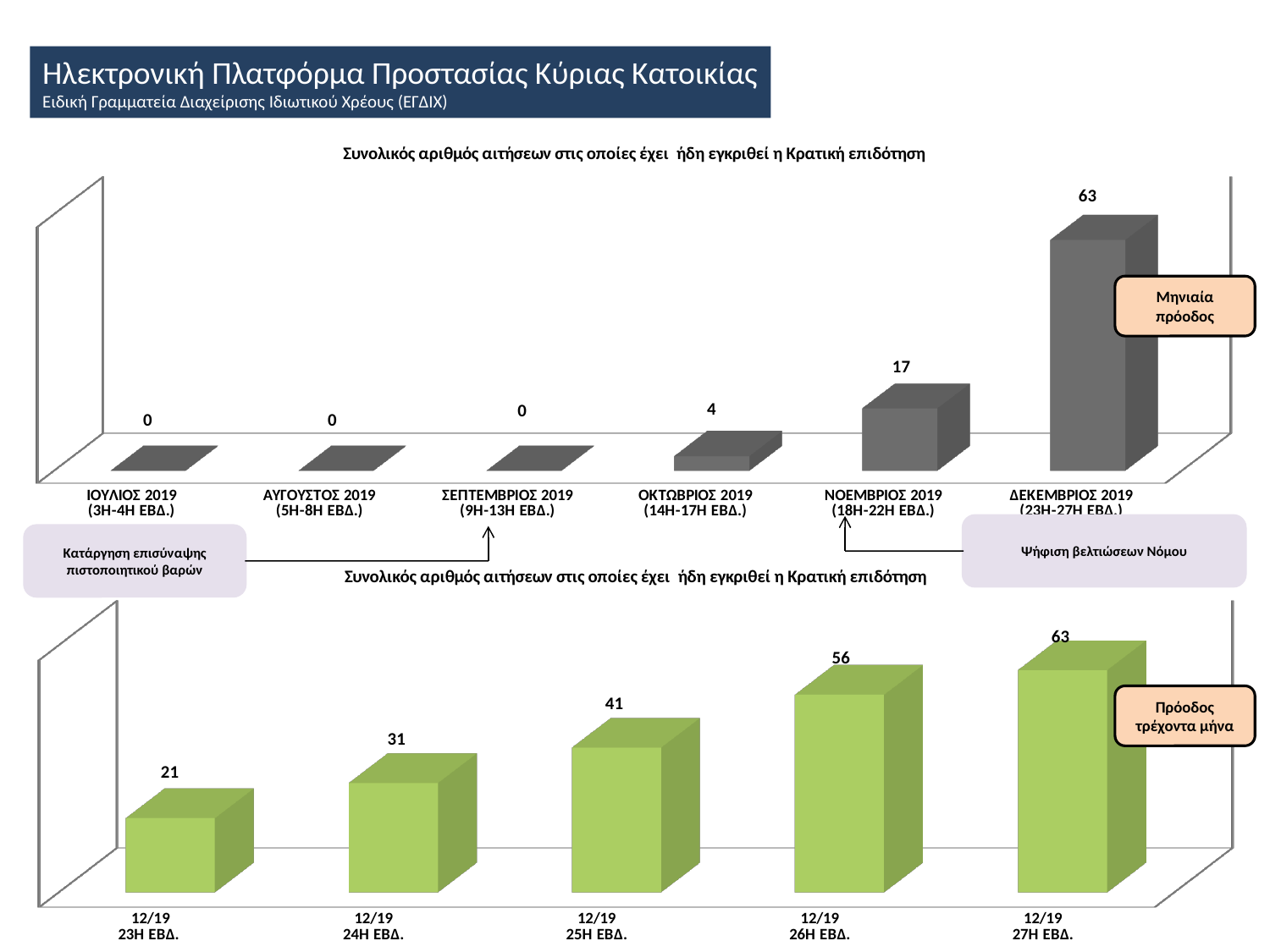
In the top chart, what is the difference between the values for ΔΕΚΕΜΒΡΙΟΣ 2019 and ΝΟΕΜΒΡΙΟΣ 2019? 46 In the bottom chart, what is the value for 12/19 23Η ΕΒΔ.? 21 In the bottom chart, do the values rise or fall from 23Η ΕΒΔ. to 27Η ΕΒΔ.? rise In the top chart, what is the value for ΟΚΤΩΒΡΙΟΣ 2019? 4 In the bottom chart, what is the difference between the values for 12/19 26Η ΕΒΔ. and 12/19 24Η ΕΒΔ.? 25 In the bottom chart, which week has the lowest value? 12/19 23Η ΕΒΔ. What kind of chart is the bottom chart? bar chart In the top chart, what is the value for ΝΟΕΜΒΡΙΟΣ 2019? 17 In the top chart, what is the value for ΔΕΚΕΜΒΡΙΟΣ 2019? 63 In the top chart, how many months are shown on the x axis? 6 In the top chart, which month has the highest value? ΔΕΚΕΜΒΡΙΟΣ 2019 In the bottom chart, what is the value for 12/19 25Η ΕΒΔ.? 41